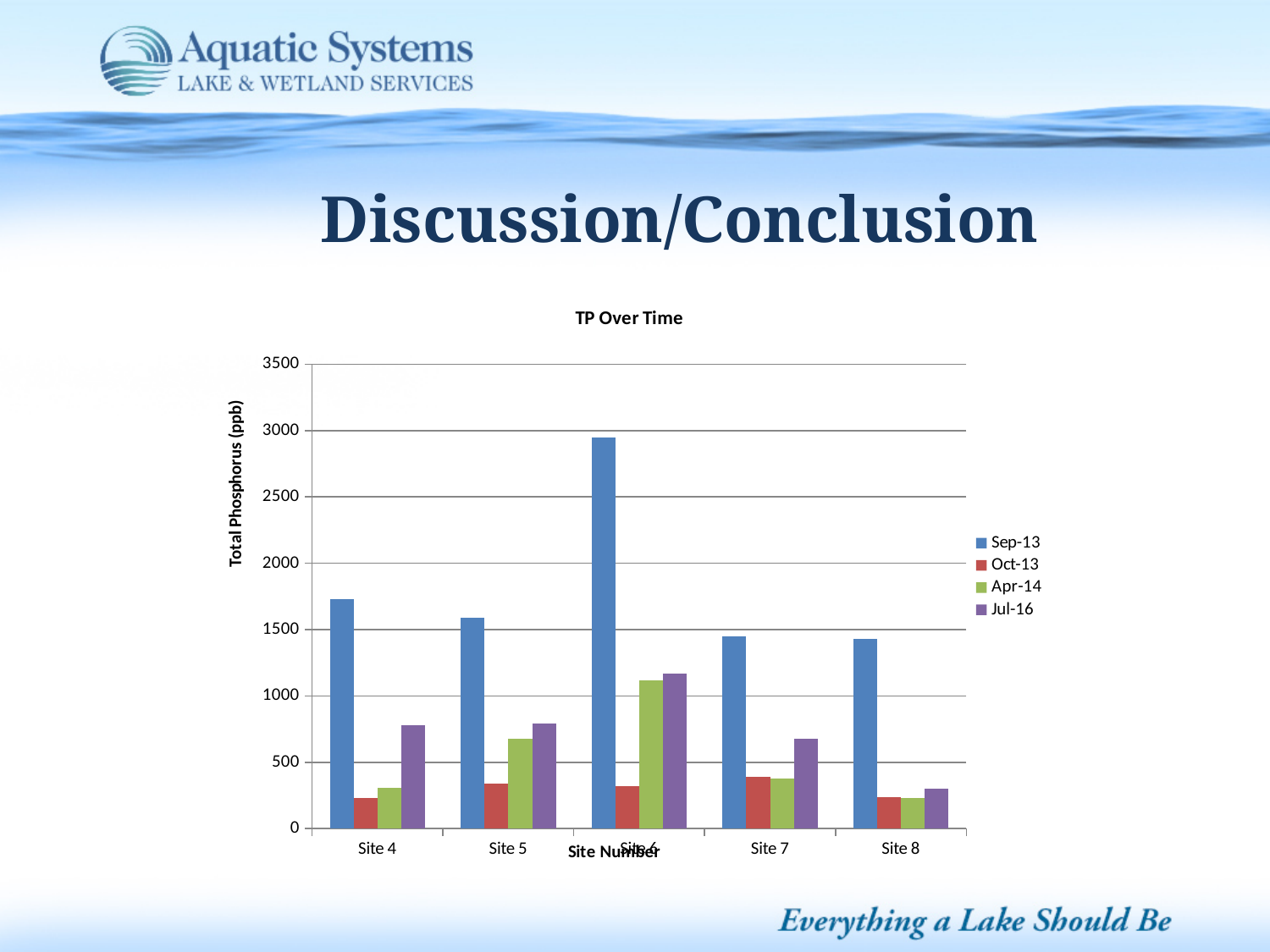
How many sites are shown on the x axis? 5 Which is larger, the Sep-13 value for Site 4 or the Sep-13 value for Site 5? Site 4 Is the Apr-14 value for Site 6 greater or less than 1000? greater Is the Oct-13 value for Site 4 greater or less than 500? less What kind of chart is shown on the slide? bar chart Which site has the highest Sep-13 value? Site 6 Which site has the highest Jul-16 value? Site 6 Which is larger at Site 5, the Apr-14 value or the Jul-16 value? Jul-16 How many series does the legend list? 4 What is the label of the y axis? Total Phosphorus (ppb) Is the Sep-13 value for Site 6 greater or less than 2500? greater What is the title of the chart? TP Over Time